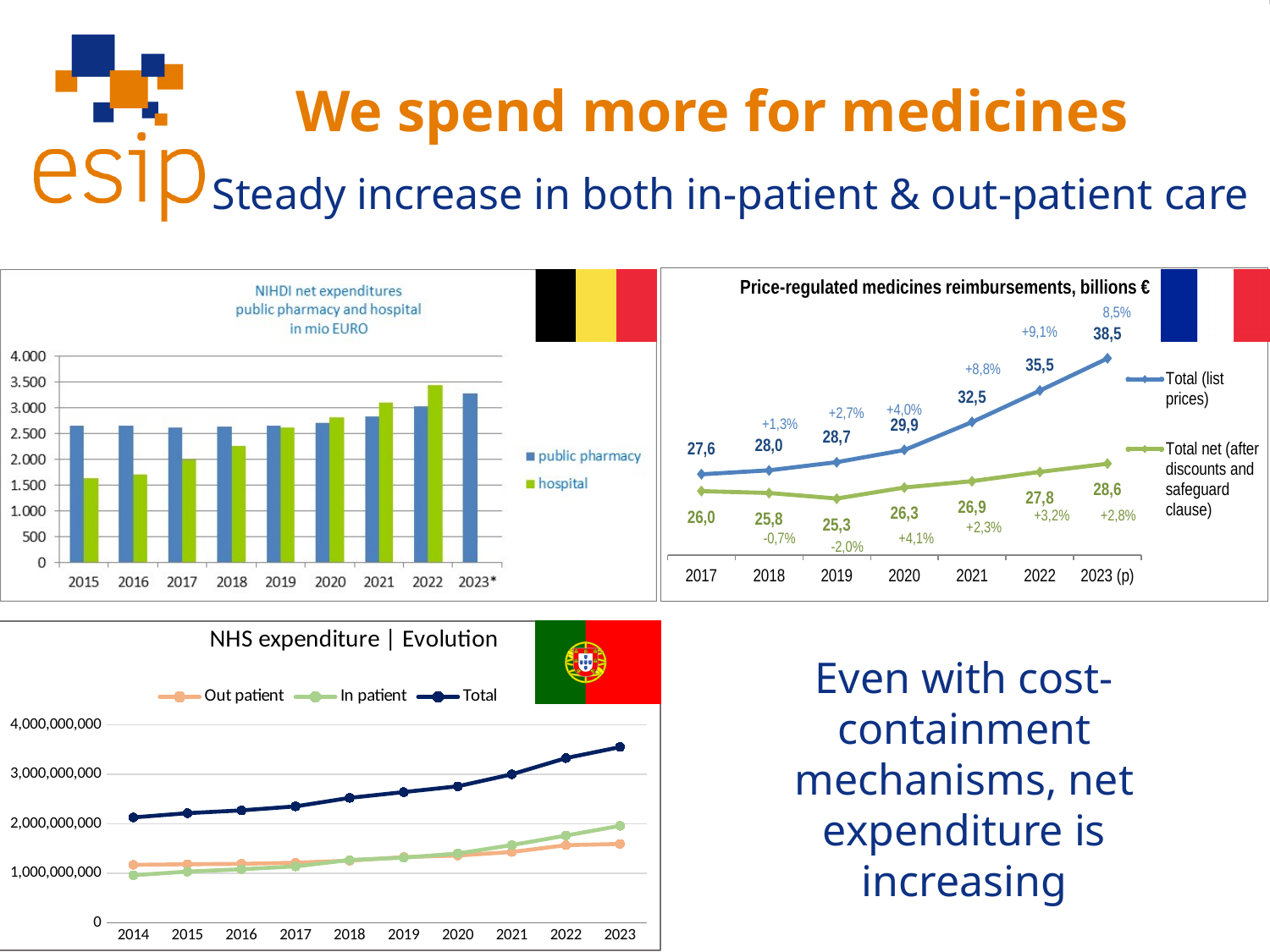
In the 'Price-regulated medicines reimbursements, billions €' chart, how many years are shown on the x axis? 7 What kind of chart is the 'NIHDI net expenditures public pharmacy and hospital in mio EURO' chart? bar chart In the 'Price-regulated medicines reimbursements, billions €' chart, does the Total (list prices) series rise or fall from 2017 to 2023 (p)? rise In the 'NIHDI net expenditures' chart, is the hospital value for 2022 greater or less than 3.000? greater In the 'NHS expenditure | Evolution' chart, how many series does the legend list? 3 In the 'NHS expenditure | Evolution' chart, is the Total value for 2023 greater or less than 3,000,000,000? greater In the 'NIHDI net expenditures' chart, how many series does the legend list? 2 In the 'Price-regulated medicines reimbursements, billions €' chart, what is the Total net (after discounts and safeguard clause) value for 2019? 25,3 In the 'Price-regulated medicines reimbursements, billions €' chart, which year has the lowest Total net value? 2019 In the 'Price-regulated medicines reimbursements, billions €' chart, what is the difference between the Total (list prices) and Total net values in 2023 (p)? 9,9 In the 'Price-regulated medicines reimbursements, billions €' chart, what is the Total (list prices) value for 2023 (p)? 38,5 In the 'NIHDI net expenditures' chart, is the hospital value for 2015 greater or less than 2.000? less